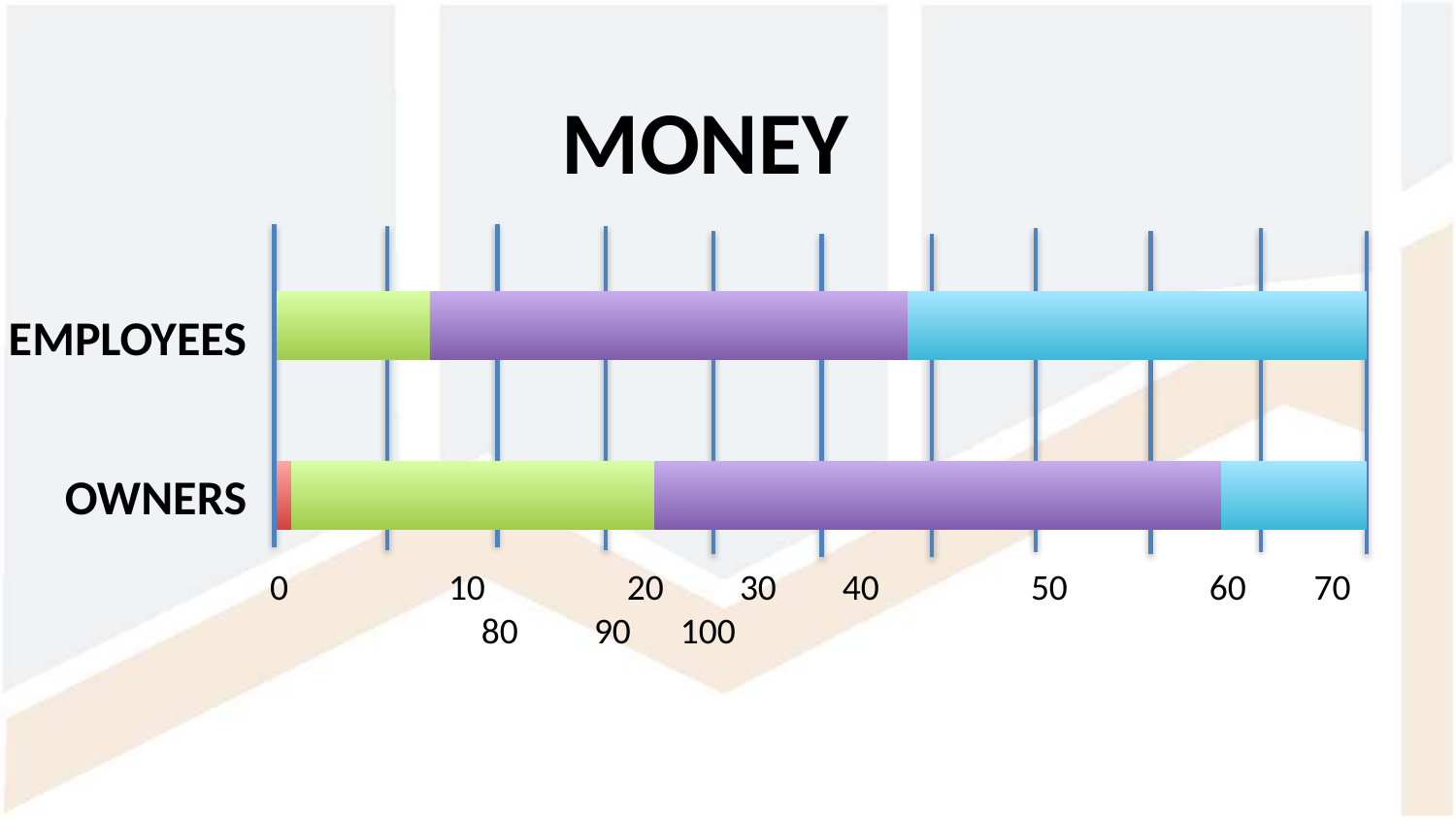
Which category's bar includes a red segment? OWNERS What is the title of the chart? MONEY What kind of chart is shown on the slide? Stacked bar chart Which category has the longer light blue segment, EMPLOYEES or OWNERS? EMPLOYEES Which category has the shorter light blue segment, EMPLOYEES or OWNERS? OWNERS How many coloured segments make up the EMPLOYEES bar? 3 Which categories are shown on the vertical axis of the chart? EMPLOYEES and OWNERS How many coloured segments make up the OWNERS bar? 4 How many categories are plotted on the chart? 2